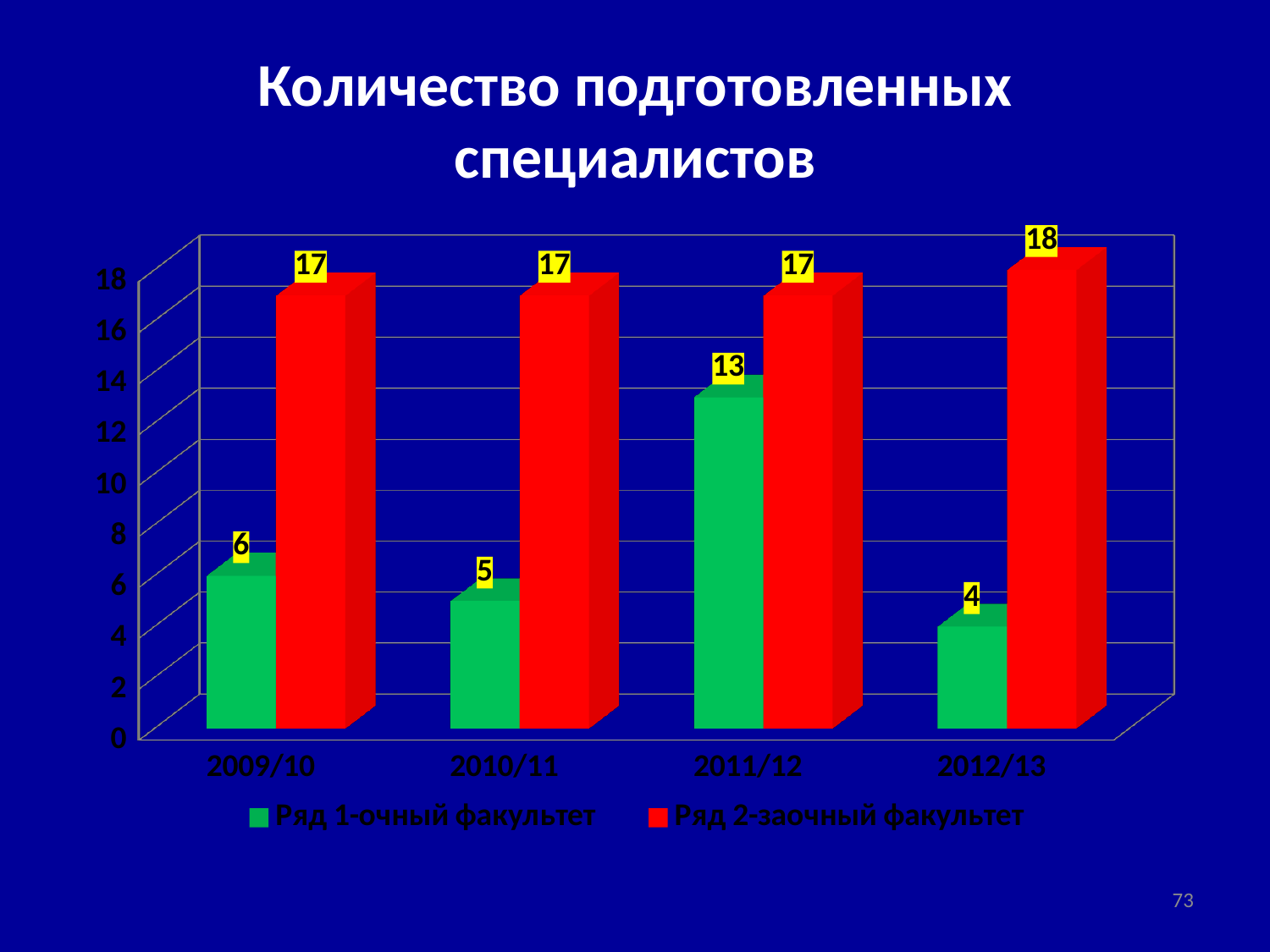
Which year has the highest value for Ряд 2-заочный факультет? 2012/13 How many years are shown on the x axis? 4 Which is larger in 2011/12: Ряд 1-очный факультет or Ряд 2-заочный факультет? Ряд 2-заочный факультет Which year has the highest value for Ряд 1-очный факультет? 2011/12 Which year has the lowest value for Ряд 1-очный факультет? 2012/13 What is the difference between Ряд 2-заочный факультет and Ряд 1-очный факультет in 2012/13? 14 What kind of chart is shown on the slide? Bar chart What is the value for Ряд 2-заочный факультет in 2012/13? 18 What is the value for Ряд 1-очный факультет in 2009/10? 6 What is the value for Ряд 1-очный факультет in 2011/12? 13 What is the title of the chart? Количество подготовленных специалистов How many series does the legend list? 2